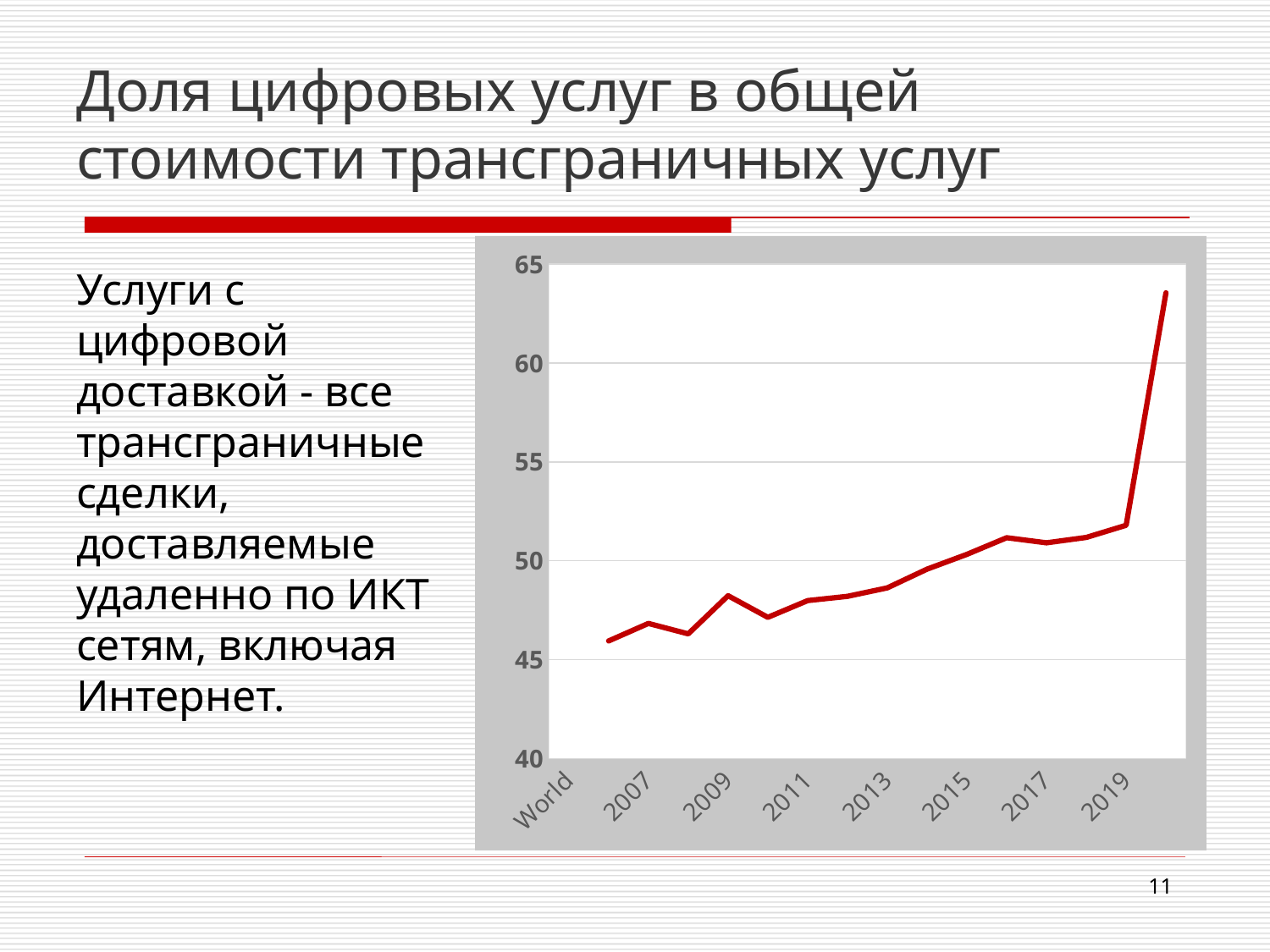
Which is larger, the value for 2015 or the value for 2011? 2015 Which is larger, the value for 2019 or the value for 2007? 2019 Is the value for 2009 greater or less than 50? less Is the value for 2007 greater or less than 50? less Is the value for 2013 greater or less than 50? less Does the line on the chart generally rise or fall from left to right? rise What is the highest value shown on the vertical axis of the chart? 65 What kind of chart is shown on the slide? line chart What colour is the line plotted on the chart? red